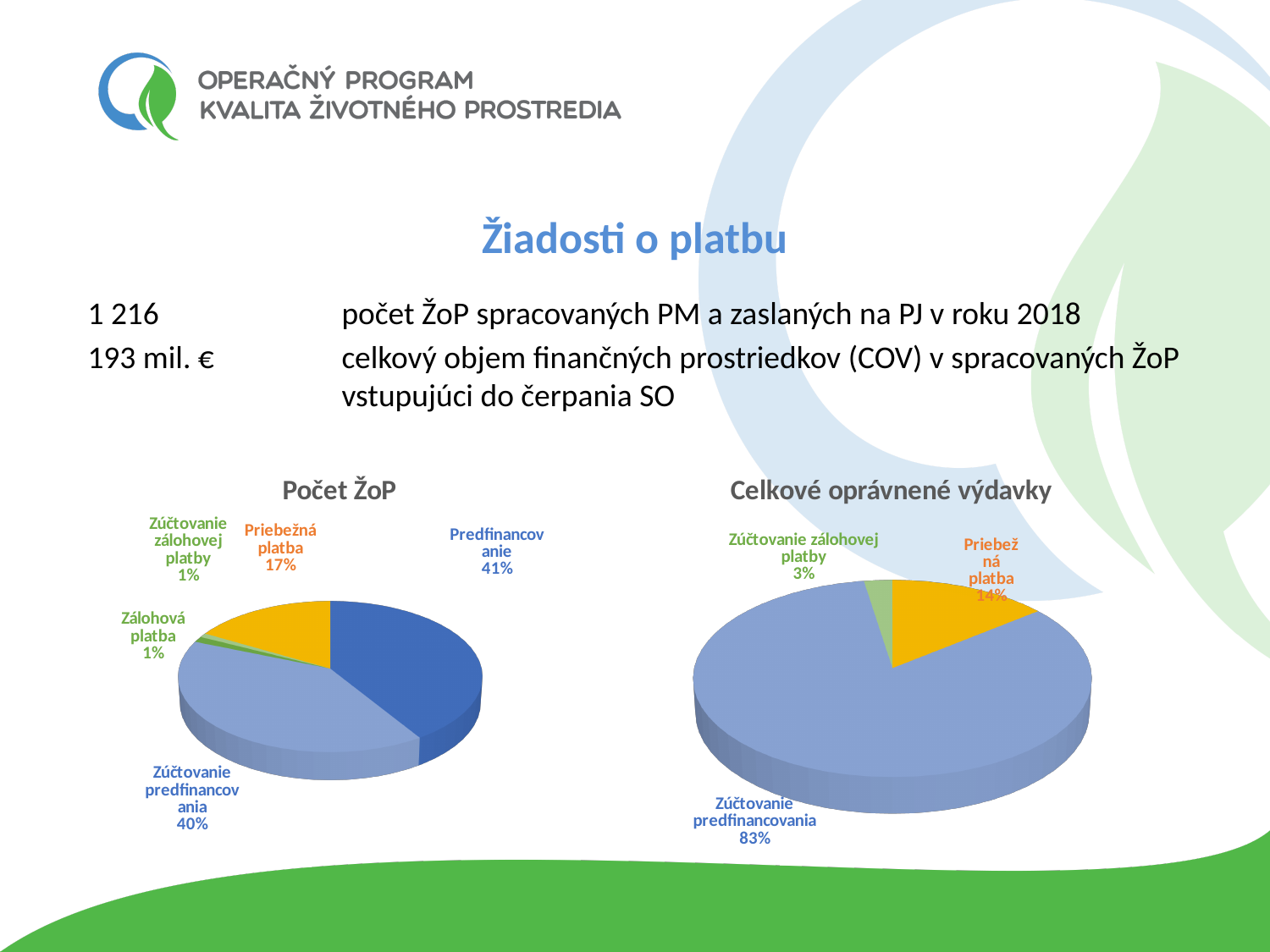
In the "Celkové oprávnené výdavky" chart, which category has the largest share? Zúčtovanie predfinancovania In the "Počet ŽoP" chart, what share does Priebežná platba have? 17% In the "Počet ŽoP" chart, how many slices does the pie have? 5 In the "Počet ŽoP" chart, what share does Zúčtovanie predfinancovania have? 40% What type of chart is the "Počet ŽoP" chart? Pie chart In the "Počet ŽoP" chart, what share does Predfinancovanie have? 41% In the "Celkové oprávnené výdavky" chart, which category has the smallest share? Zúčtovanie zálohovej platby In the "Počet ŽoP" chart, what is the difference in percentage points between Predfinancovanie and Priebežná platba? 24 In the "Celkové oprávnené výdavky" chart, how many slices does the pie have? 3